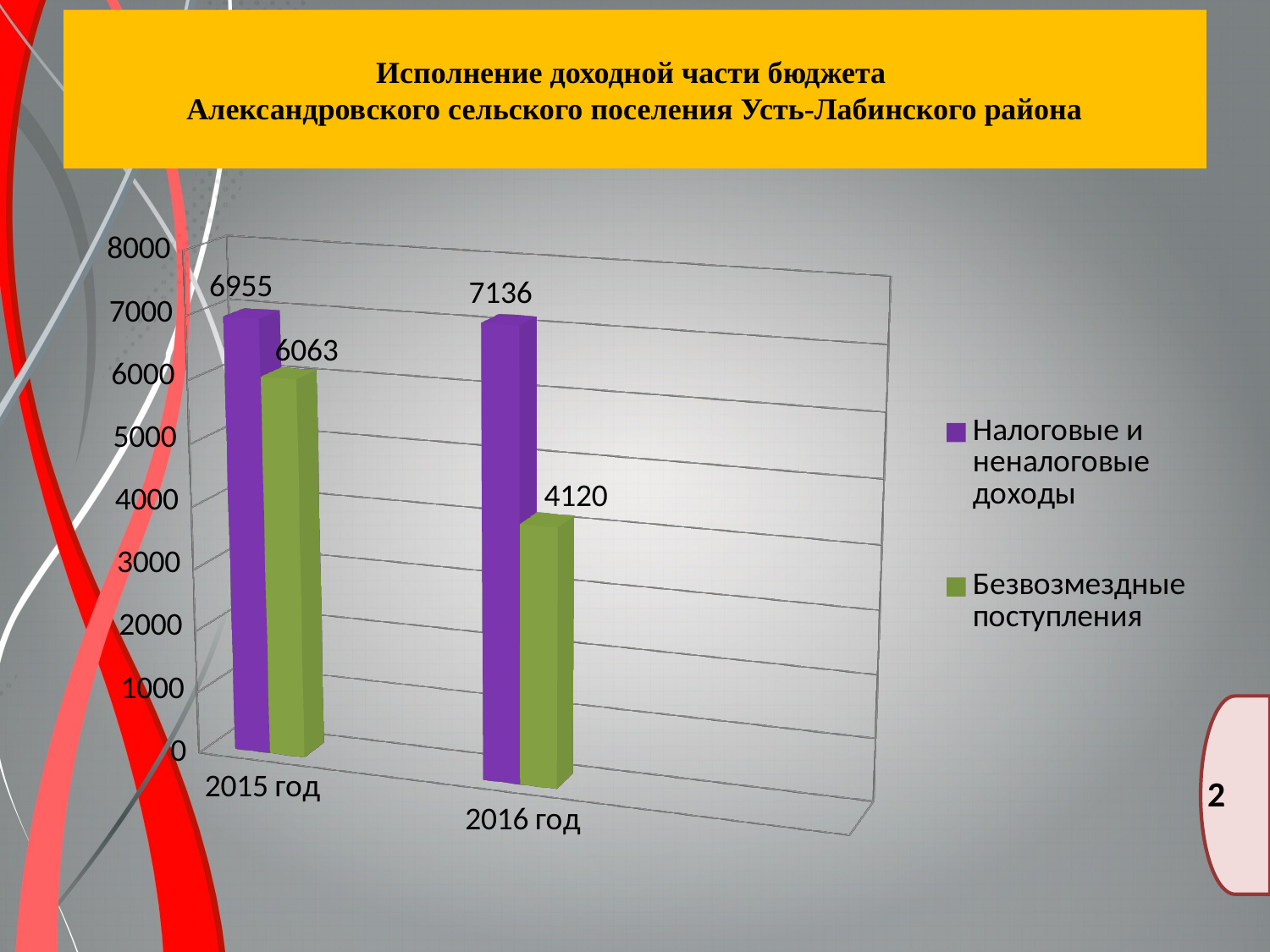
What is the value of Налоговые и неналоговые доходы for 2016 год? 7136 What is the difference between Безвозмездные поступления in 2015 год and 2016 год? 1943 Does Безвозмездные поступления rise or fall from 2015 год to 2016 год? fall Which year has the lower value for Безвозмездные поступления? 2016 год What is the value of Безвозмездные поступления for 2015 год? 6063 Which year has the higher value for Налоговые и неналоговые доходы? 2016 год What is the value of Налоговые и неналоговые доходы for 2015 год? 6955 How many series does the legend list? 2 What kind of chart is shown on the slide? bar chart What is the difference between Налоговые и неналоговые доходы and Безвозмездные поступления in 2016 год? 3016 Which is larger in 2015 год: Налоговые и неналоговые доходы or Безвозмездные поступления? Налоговые и неналоговые доходы What is the value of Безвозмездные поступления for 2016 год? 4120